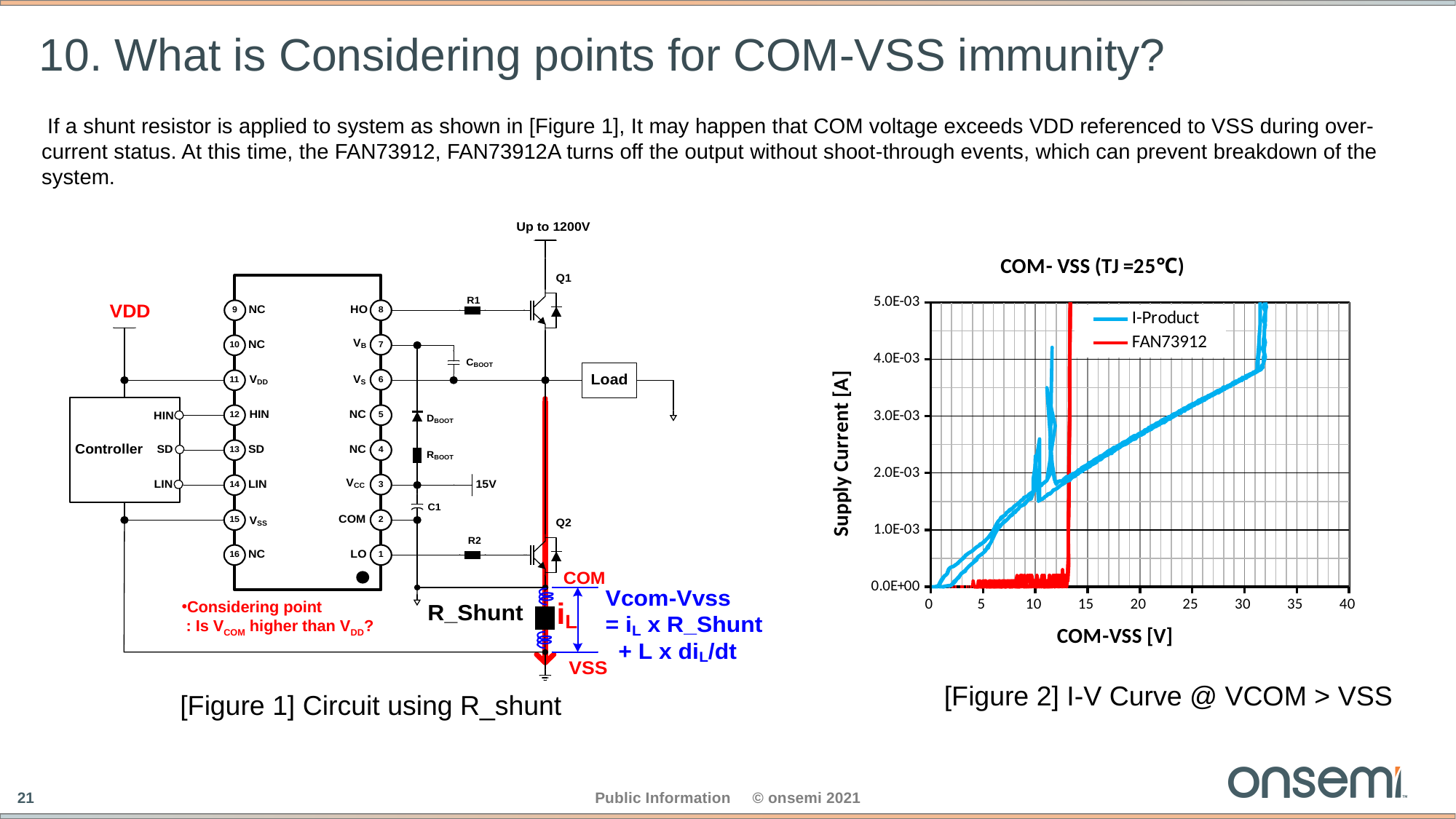
In the COM-VSS chart, is the supply current of I-Product at 25 V greater or less than 2.0E-03 A? greater How many series does the legend of the COM-VSS chart list? 2 What is the title of the chart in Figure 2? COM- VSS (TJ =25℃) In the COM-VSS chart, which series has the higher supply current at 25 V, I-Product or FAN73912? I-Product In the COM-VSS chart, is the supply current of I-Product at 20 V greater or less than 3.0E-03 A? less In the COM-VSS chart, is the supply current of FAN73912 at 10 V greater or less than 1.0E-03 A? less In the COM-VSS chart, does the I-Product supply current rise or fall as COM-VSS increases from 5 V to 30 V? rise What kind of chart is shown in Figure 2? line chart What are the two series named in the legend of the COM-VSS chart? I-Product and FAN73912 What is the maximum value shown on the x axis of the COM-VSS chart? 40